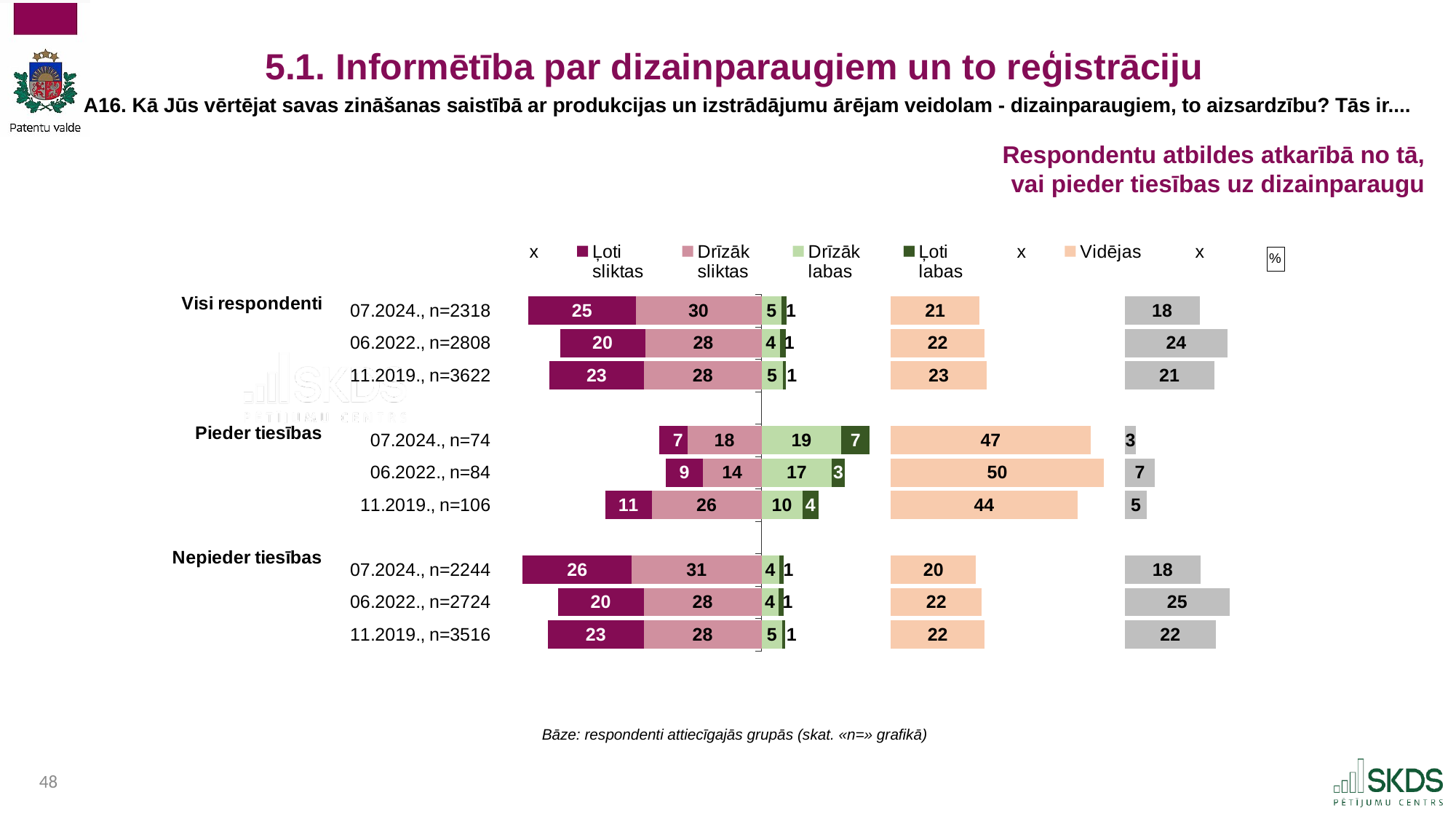
What is the value for "Drīzāk labas" for Pieder tiesības, 07.2024., n=74? 19 What is the value for "Vidējas" for Pieder tiesības, 06.2022., n=84? 50 What is the value for "Drīzāk sliktas" for Nepieder tiesības, 07.2024., n=2244? 31 What is the combined total of "Ļoti sliktas" and "Drīzāk sliktas" for Visi respondenti, 07.2024., n=2318? 55 Which is larger: the "Ļoti sliktas" value for Visi respondenti 11.2019., n=3622 or for Visi respondenti 06.2022., n=2808? 11.2019., n=3622 What is the value for "Ļoti labas" for Pieder tiesības, 11.2019., n=106? 4 What is the difference between the "Vidējas" values for Pieder tiesības 07.2024., n=74 and Nepieder tiesības 07.2024., n=2244? 27 Among the three Pieder tiesības rows, which has the highest "Vidējas" value? 06.2022., n=84 Which colour represents "Vidējas" in the chart? Light orange (peach) What type of chart is shown on the slide? Bar chart What is the value for "Ļoti sliktas" for Visi respondenti, 07.2024., n=2318? 25 Among the three Nepieder tiesības rows, which has the lowest "Ļoti sliktas" value? 06.2022., n=2724